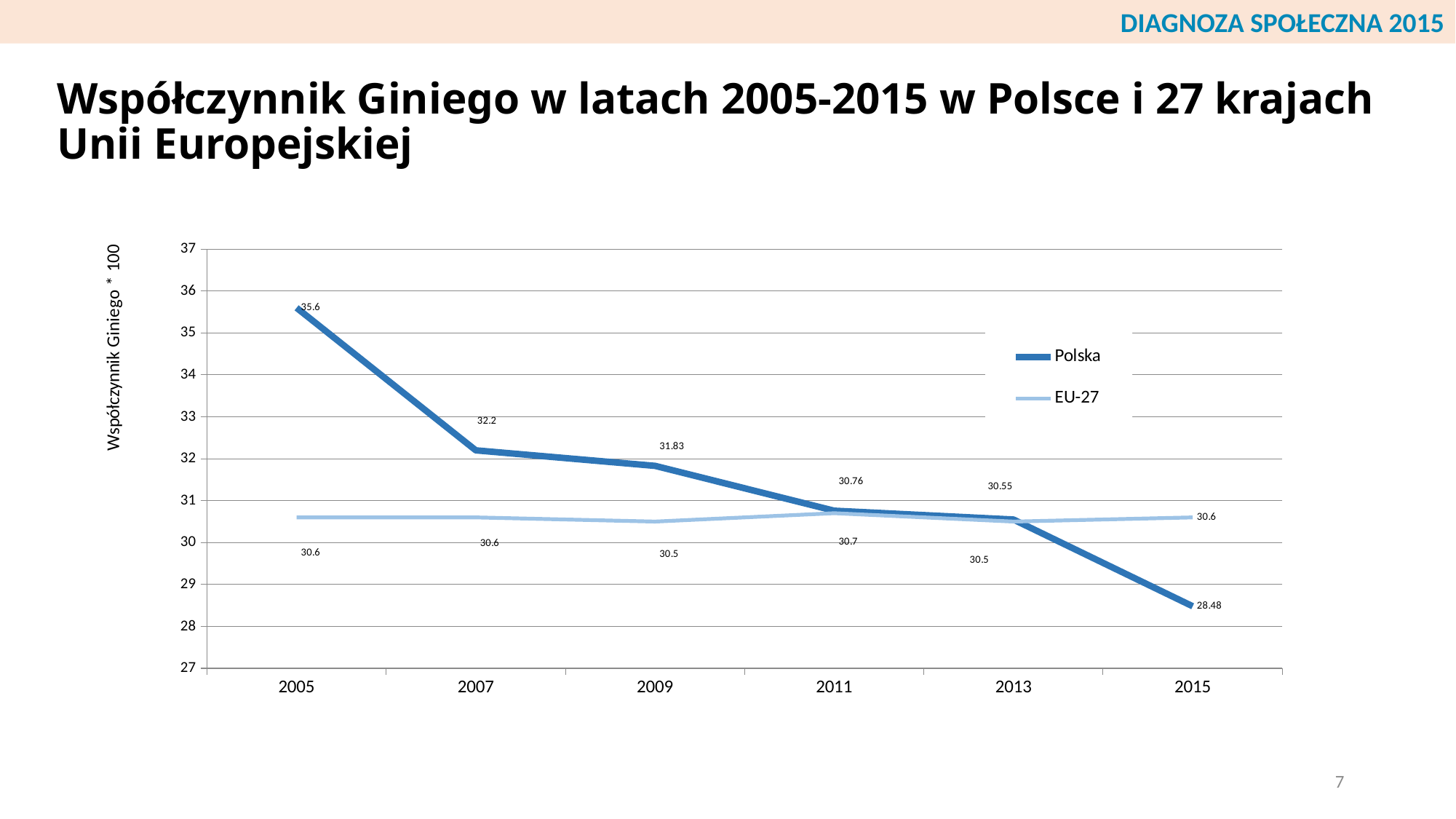
Is the value for Polska in 2007 greater or less than 32? greater What is the value for Polska in 2005? 35.6 What is the value for Polska in 2009? 31.83 In which year is the Polska value highest? 2005 What is the value for EU-27 in 2011? 30.7 What is the value for Polska in 2015? 28.48 In which year is the Polska value lowest? 2015 Which is larger in 2015, the Polska value or the EU-27 value? EU-27 How many years are shown on the x axis? 6 What kind of chart is shown on the slide? Line chart What is the difference between the Polska values in 2005 and 2007? 3.4 How many series does the legend list? 2